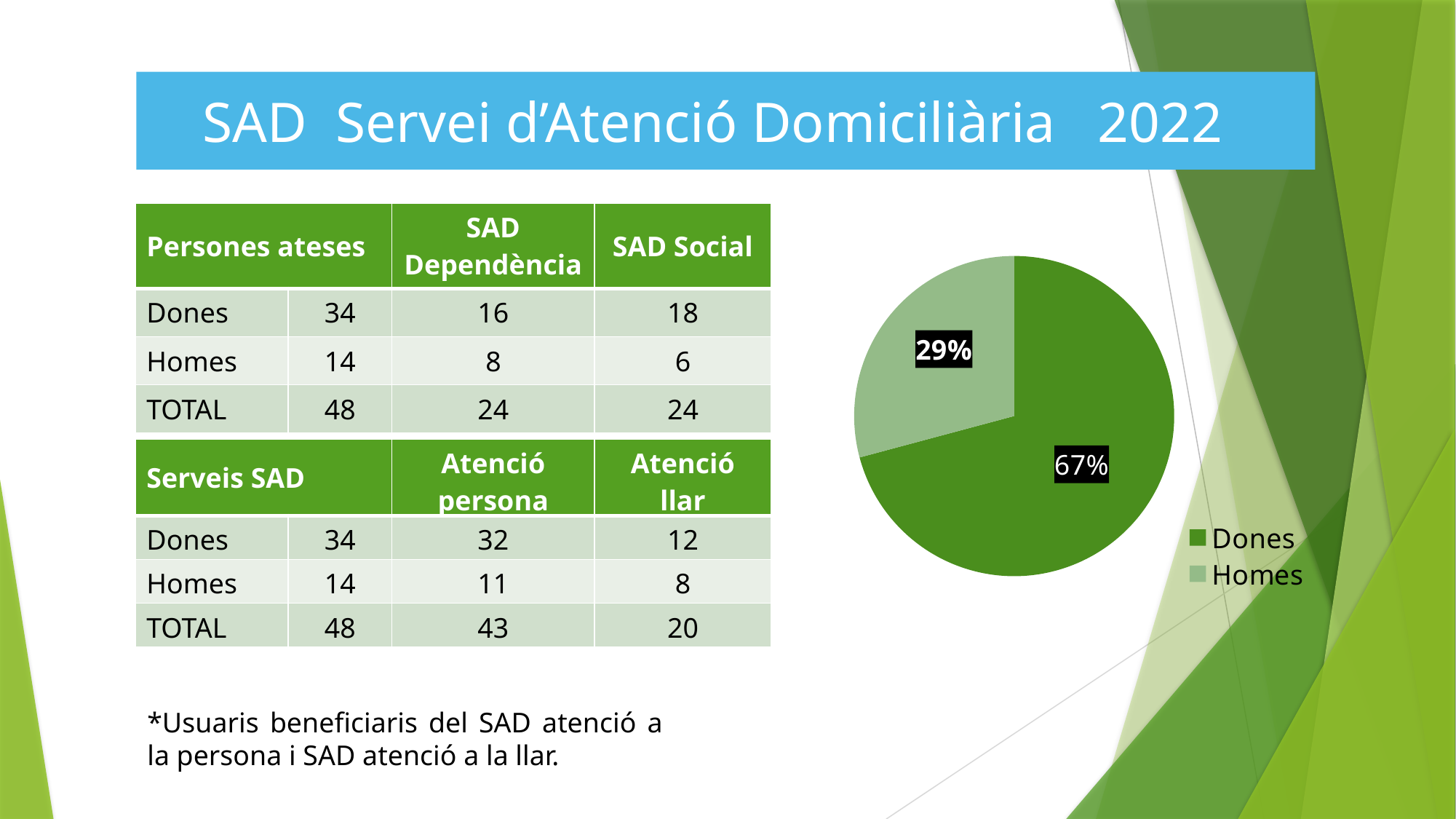
What kind of chart is shown on the slide? pie chart What percentage does the pie chart show for Homes? 29% Which slice of the pie chart is the smallest? Homes Which legend entry of the pie chart is shown in light green? Homes What percentage does the pie chart show for Dones? 67% Which legend entry of the pie chart is shown in dark green? Dones How many slices does the pie chart have? 2 Which slice of the pie chart is the largest? Dones In the pie chart, which is larger, Dones or Homes? Dones What is the difference in percentage points between the Dones and Homes slices of the pie chart? 38 How many entries does the pie chart legend list? 2